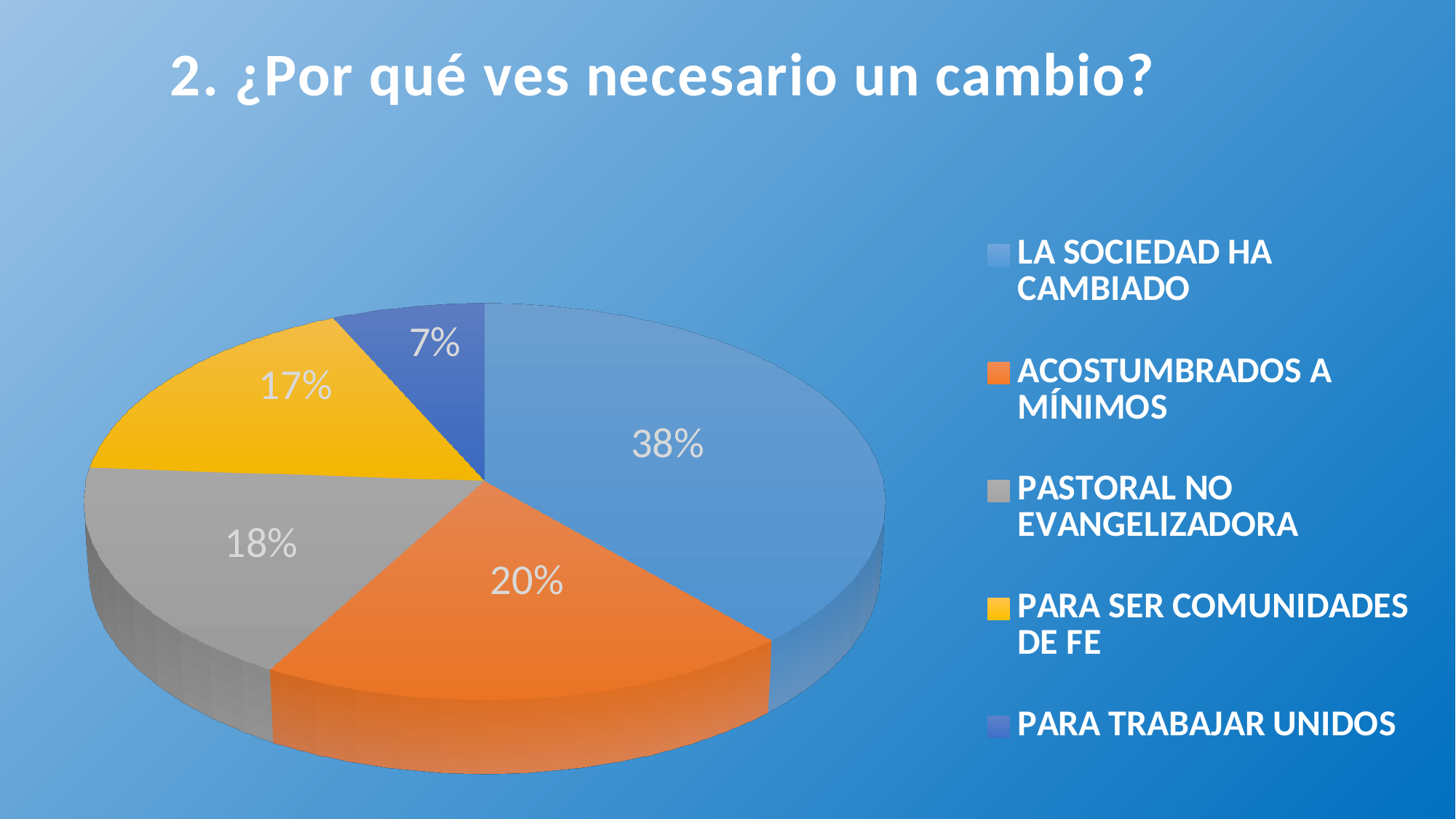
What percentage is shown for LA SOCIEDAD HA CAMBIADO? 38% What is the difference in percentage points between LA SOCIEDAD HA CAMBIADO and ACOSTUMBRADOS A MÍNIMOS? 18 What percentage is shown for ACOSTUMBRADOS A MÍNIMOS? 20% Which category has the largest share of the pie? LA SOCIEDAD HA CAMBIADO Which category has the smallest share of the pie? PARA TRABAJAR UNIDOS What type of chart is shown on the slide? Pie chart Which is larger, the share for PASTORAL NO EVANGELIZADORA or the share for PARA TRABAJAR UNIDOS? PASTORAL NO EVANGELIZADORA What colour is the slice for PARA SER COMUNIDADES DE FE? Yellow How many categories does the legend list? 5 What percentage is shown for PASTORAL NO EVANGELIZADORA? 18% What percentage is shown for PARA TRABAJAR UNIDOS? 7% What percentage is shown for PARA SER COMUNIDADES DE FE? 17%